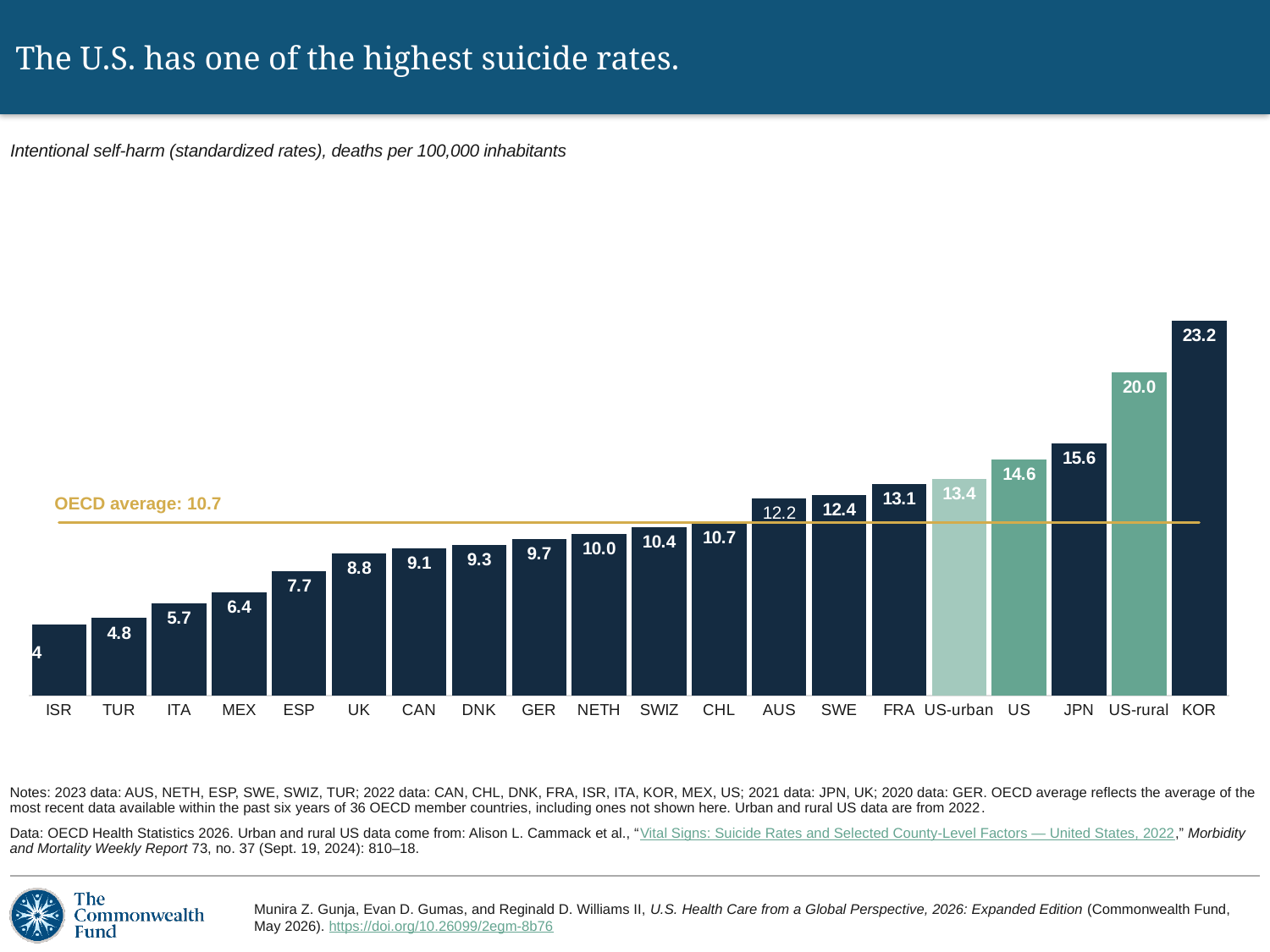
How many bars are shown on the chart? 20 What is the value shown for US-urban? 13.4 What OECD average value is marked by the horizontal line on the chart? 10.7 What is the difference between the suicide rates of KOR and JPN? 7.6 Which country has the highest suicide rate on the chart? KOR Which has a higher suicide rate, the US or FRA? US What type of chart is shown on the slide? Bar chart Which country has the lowest suicide rate on the chart? ISR What is the suicide rate for KOR? 23.2 What is the value shown for US-rural? 20.0 What is the suicide rate for the US? 14.6 What is the difference between the US-rural and US-urban suicide rates? 6.6